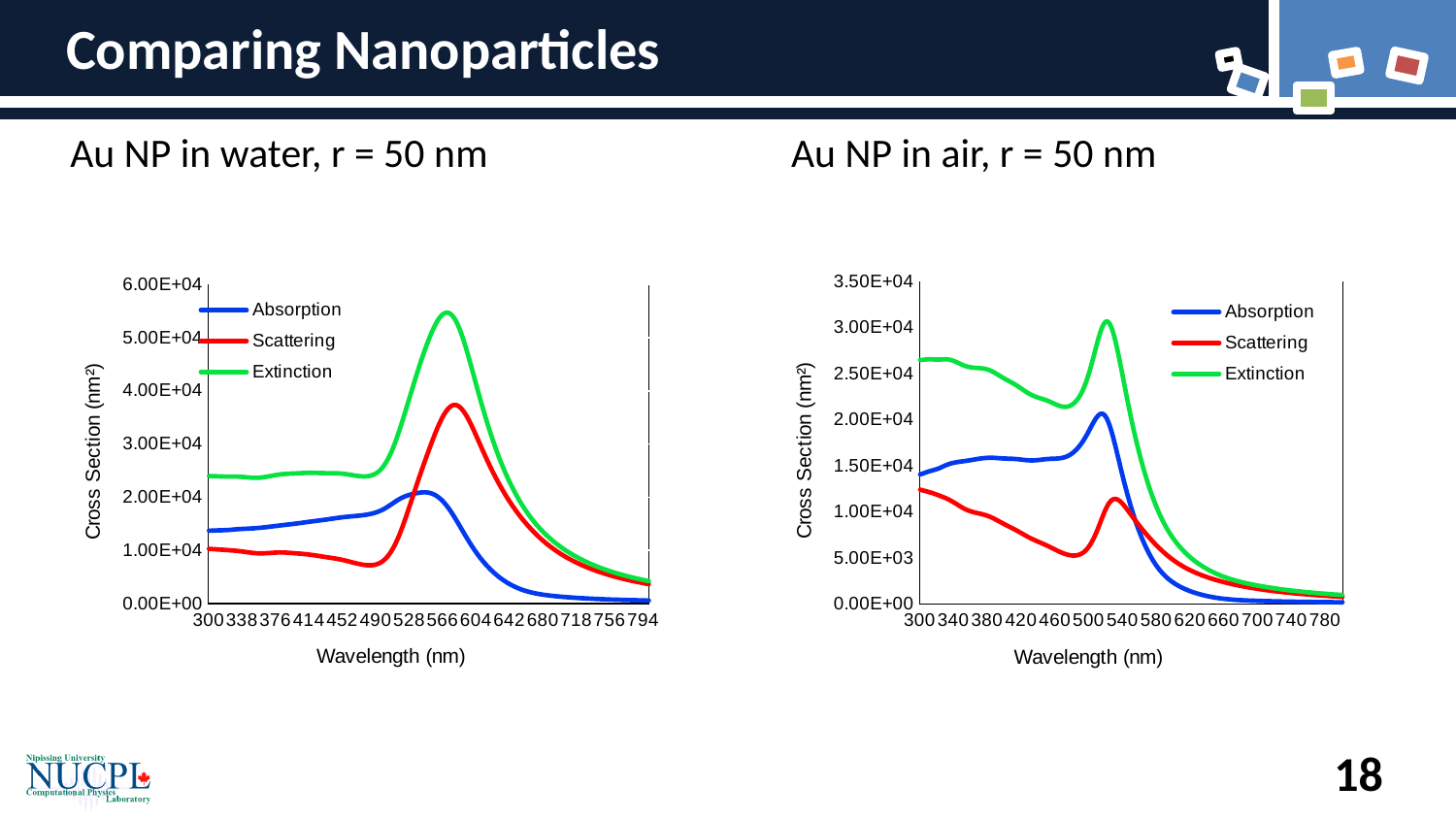
In the 'Au NP in air, r = 50 nm' chart, which series has the larger value at 300 nm, Absorption or Scattering? Absorption In the 'Au NP in water, r = 50 nm' chart, is the peak value of Absorption greater or less than 3.00E+04? less In the 'Au NP in air, r = 50 nm' chart, does the Extinction curve rise or fall between 620 nm and 780 nm? fall In the 'Au NP in water, r = 50 nm' chart, which series reaches the highest peak value? Extinction In the 'Au NP in air, r = 50 nm' chart, is the peak value of Scattering greater or less than 1.50E+04? less In the 'Au NP in air, r = 50 nm' chart, which series has the lowest peak value? Scattering In the 'Au NP in water, r = 50 nm' chart, which series has the larger peak value, Scattering or Absorption? Scattering In the 'Au NP in air, r = 50 nm' chart, is the peak value of Extinction greater or less than 2.50E+04? greater What kind of chart is the 'Au NP in water, r = 50 nm' chart? Line chart What are the legend entries on the 'Au NP in air, r = 50 nm' chart? Absorption, Scattering, Extinction How many series does the legend of the 'Au NP in water, r = 50 nm' chart list? 3